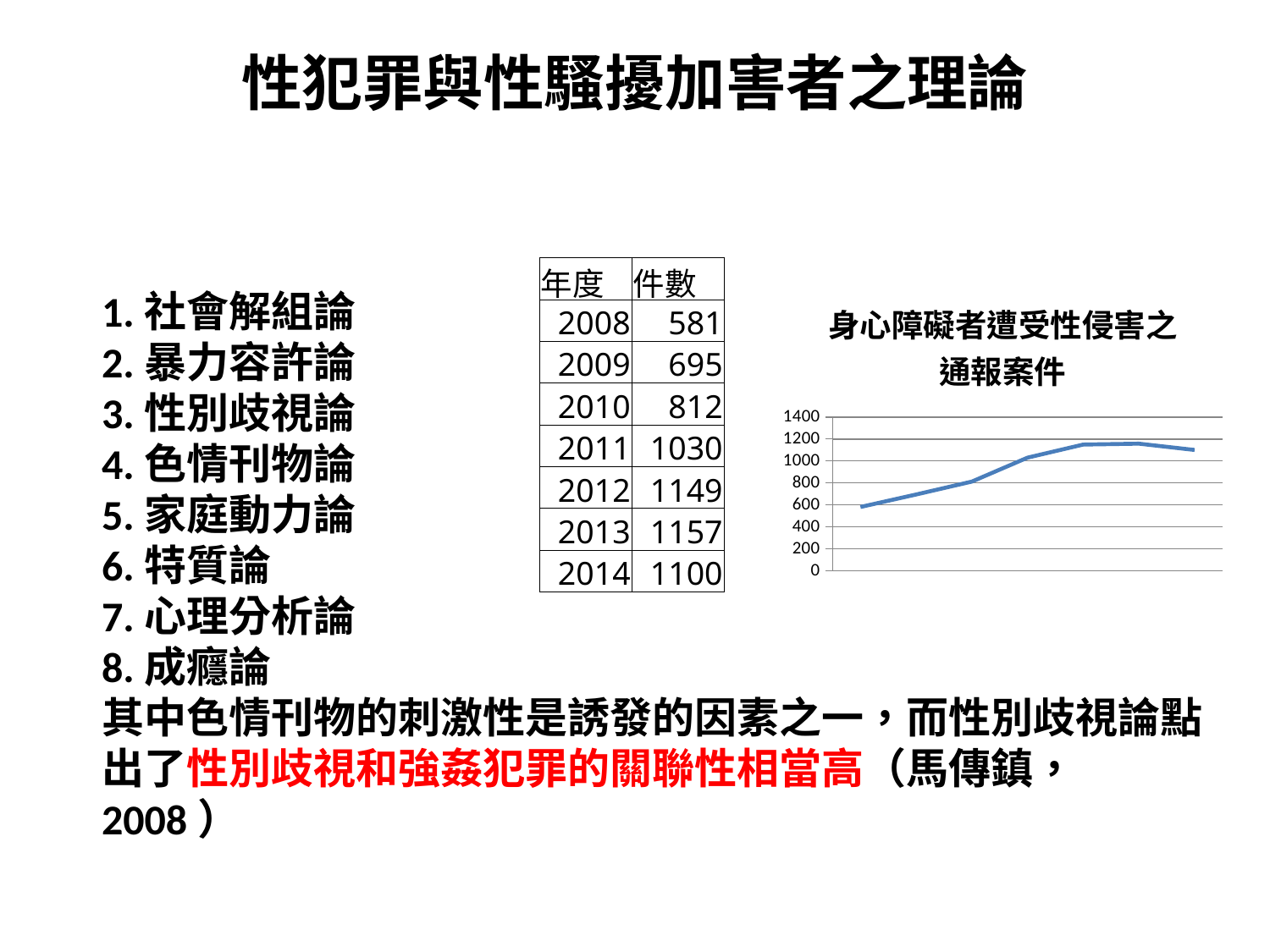
What is the title of the chart? 身心障礙者遭受性侵害之通報案件 According to the table accompanying the chart, how many cases (件數) were reported in 2012? 1149 Is the value of the last point on the line greater or less than 1000? greater Is the peak value of the line greater or less than 1200? less According to the table accompanying the chart, what is the difference in cases between 2014 and 2008? 519 What kind of chart is shown on the slide? line chart According to the table accompanying the chart, which year had the lowest number of cases? 2008 How many data points are plotted on the line chart? 7 What is the highest value shown on the chart's vertical axis? 1400 Is the value of the second point on the line greater or less than 800? less Does the line generally rise or fall from the first point to the sixth point? rise According to the table accompanying the chart, which year had the highest number of cases? 2013